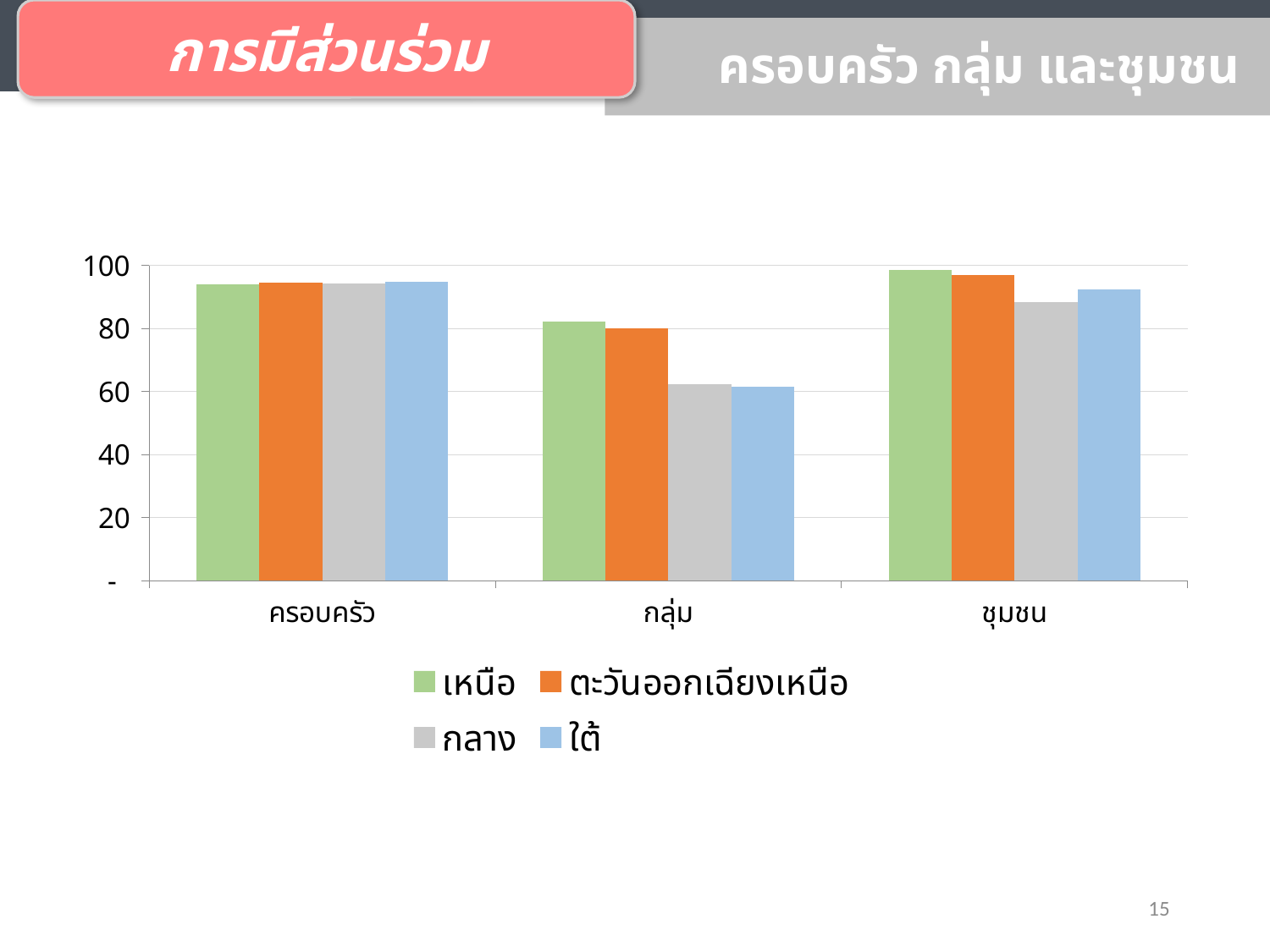
How many categories are shown on the x axis of the chart? 3 Is the value for ตะวันออกเฉียงเหนือ in the ครอบครัว category greater or less than 80? greater Is the value for ใต้ in the กลุ่ม category greater or less than 80? less In the ชุมชน category, which series has the lowest value? กลาง In the กลุ่ม category, which is larger: the value for เหนือ or the value for กลาง? เหนือ What are the four series listed in the chart legend? เหนือ, ตะวันออกเฉียงเหนือ, กลาง, ใต้ Is the value for เหนือ in the ชุมชน category greater or less than 80? greater What kind of chart is shown on the slide? bar chart For the กลาง series, which category has the lowest value? กลุ่ม How many series does the chart legend list? 4 In the ชุมชน category, which is larger: the value for กลาง or the value for ใต้? ใต้